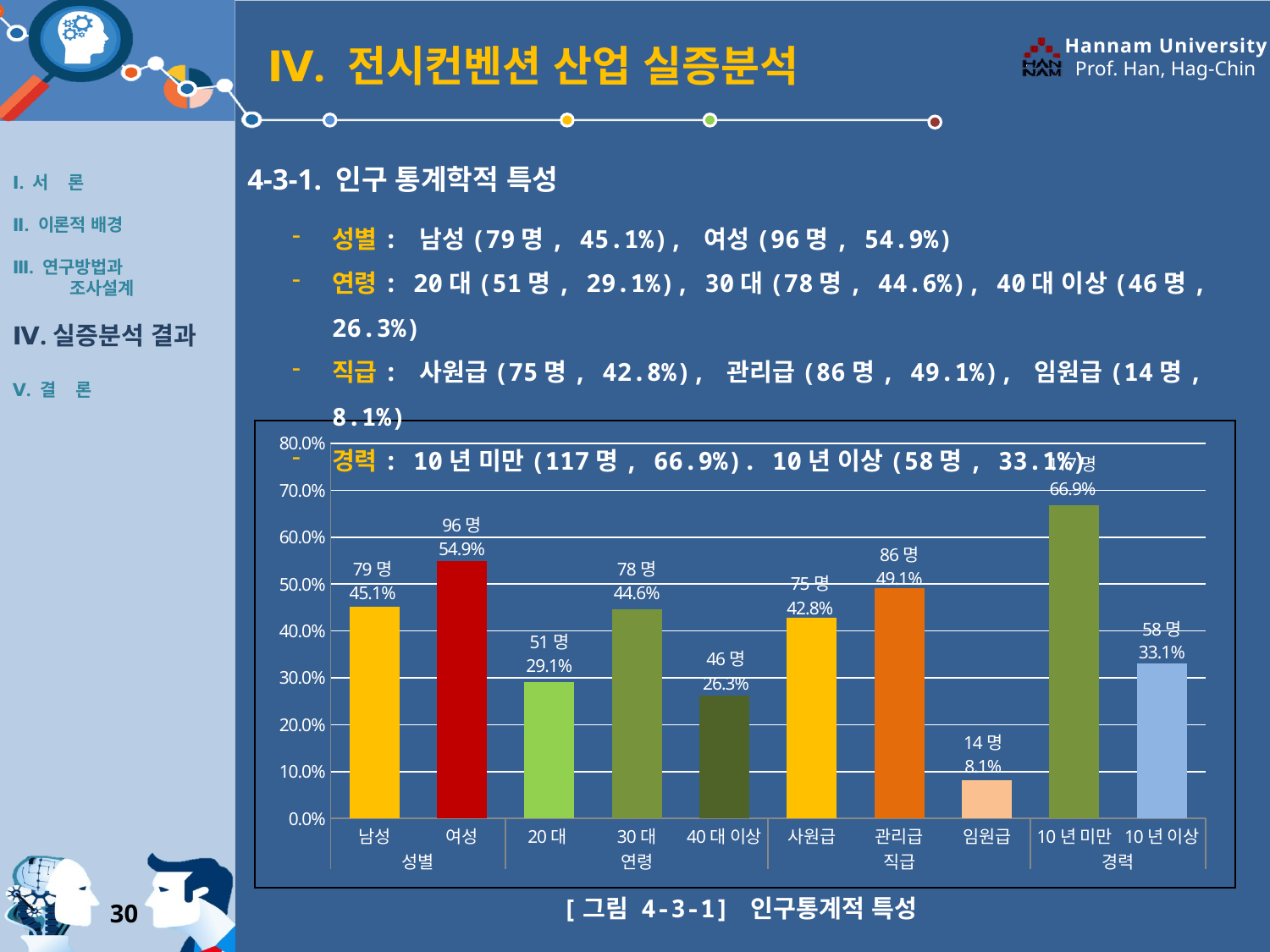
How many people (명) are shown for the 30 대 bar? 78 명 Which bar is taller, 관리급 or 사원급? 관리급 What is the difference in percentage between 여성 and 남성? 9.8% What is the caption printed below the chart? [그림 4-3-1] 인구통계적 특성 How many bars are plotted in the chart? 10 What is the difference in number of people between 10 년 미만 and 10 년 이상? 59 명 What kind of chart is shown on the slide? bar chart What percentage is shown for 여성 in the chart? 54.9% Which category has the highest bar in the chart? 10 년 미만 What percentage is shown for 임원급? 8.1% Which category has the lowest bar in the chart? 임원급 Is the value for 40 대 이상 greater or less than 30.0%? less